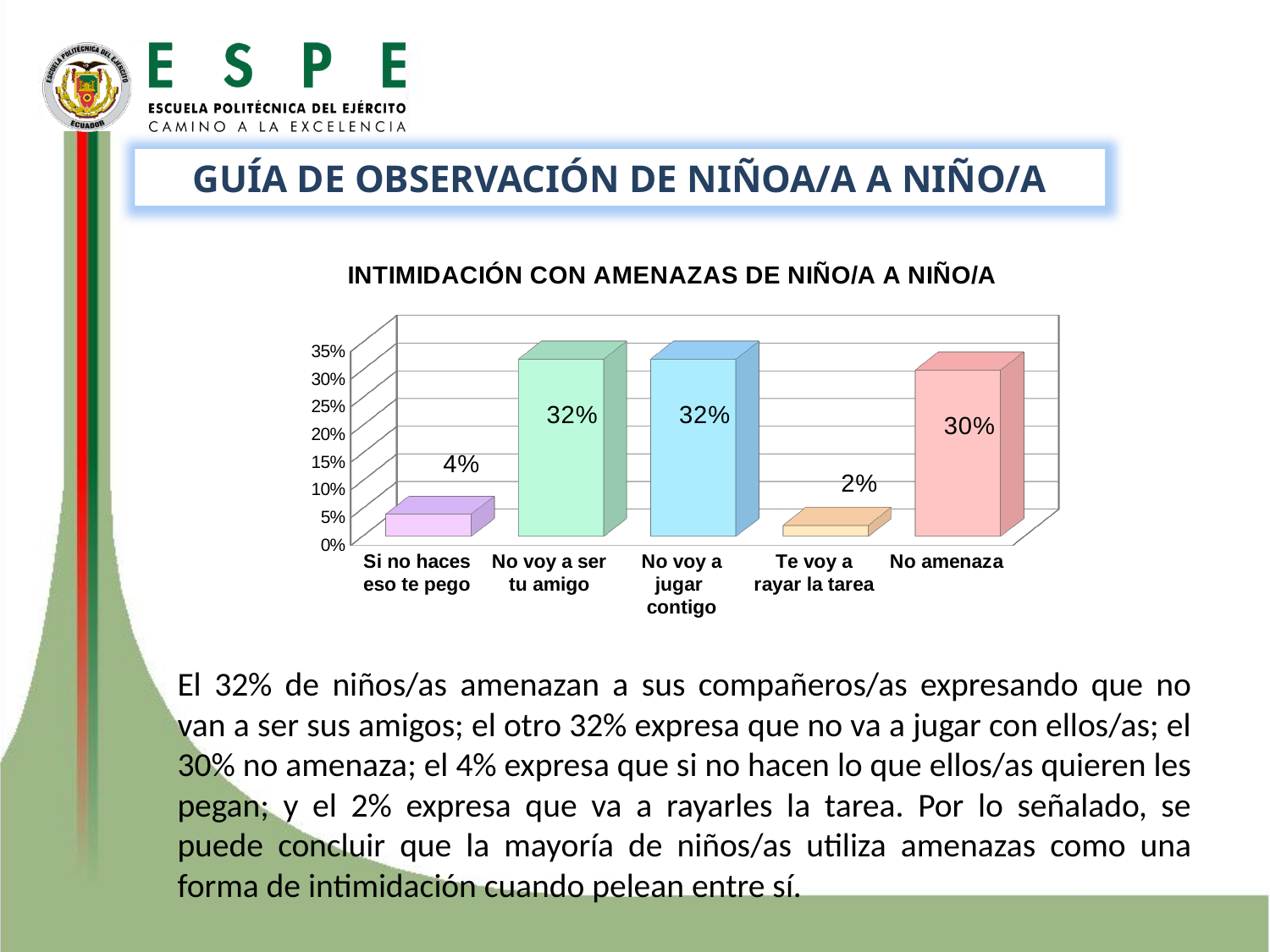
What is the value for "No amenaza"? 30% Is the value for "No amenaza" greater or less than 25%? greater Which category has the lowest value? Te voy a rayar la tarea What is the value for "Te voy a rayar la tarea"? 2% What is the difference between the values for "No voy a jugar contigo" and "No amenaza"? 2% What is the title of the chart? INTIMIDACIÓN CON AMENAZAS DE NIÑO/A A NIÑO/A What kind of chart is shown on the slide? bar chart What is the value for "Si no haces eso te pego"? 4% What is the value for "No voy a ser tu amigo"? 32% Which is larger, the value for "No amenaza" or the value for "Si no haces eso te pego"? No amenaza What is the difference between the values for "Si no haces eso te pego" and "Te voy a rayar la tarea"? 2% How many categories are shown in the chart? 5